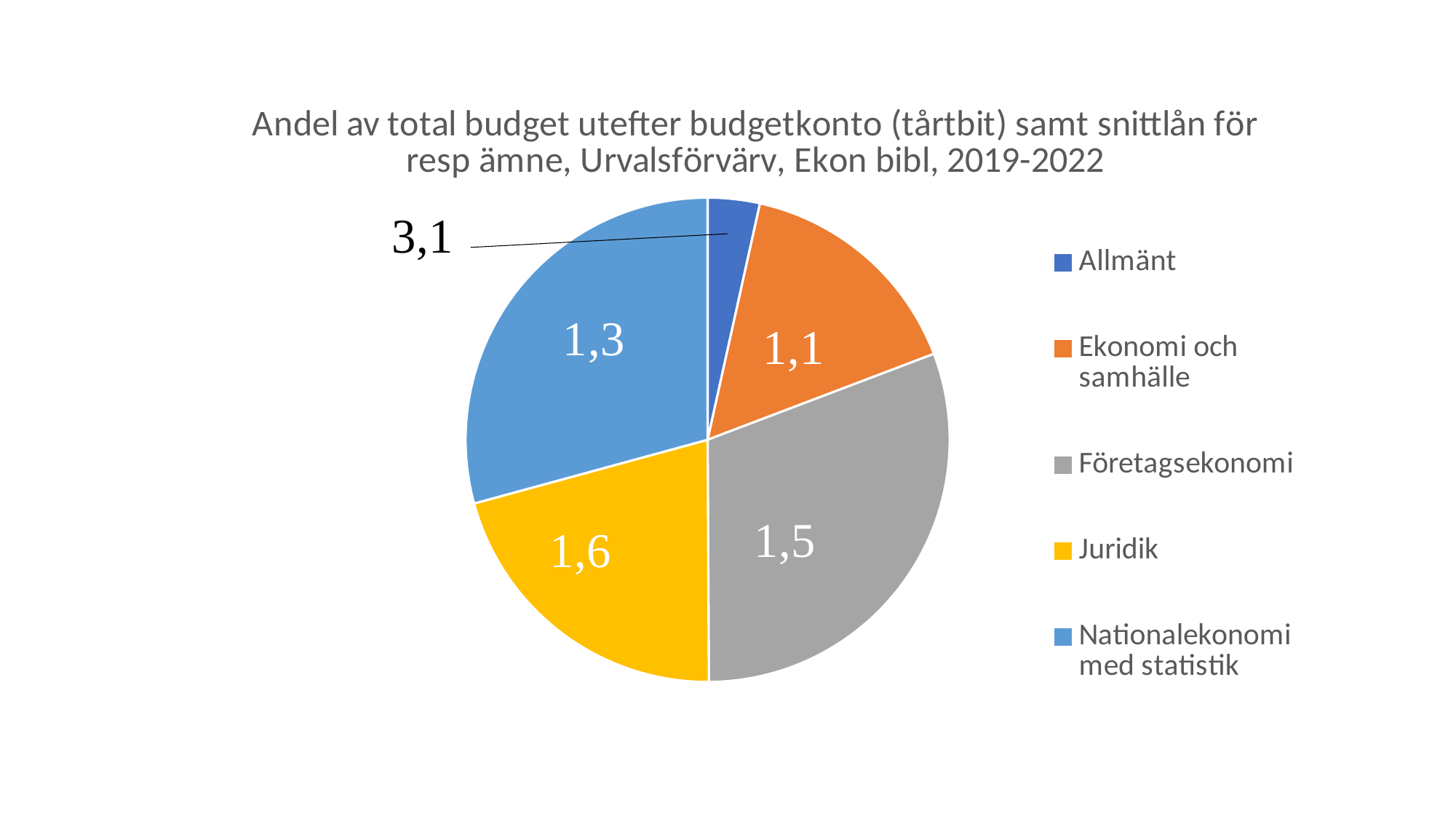
What data label is shown on the Juridik slice? 1,6 How many entries does the legend list? 5 What data label is shown on the Ekonomi och samhälle slice? 1,1 Which slice has the highest data label value? Allmänt What data label is shown on the Företagsekonomi slice? 1,5 Which slice is larger, Nationalekonomi med statistik or Juridik? Nationalekonomi med statistik What colour is the Juridik slice? yellow What data label is shown on the Nationalekonomi med statistik slice? 1,3 Which category has the smallest slice of the pie? Allmänt What kind of chart is shown on the slide? pie chart How many slices does the pie chart have? 5 What data label is shown on the Allmänt slice? 3,1